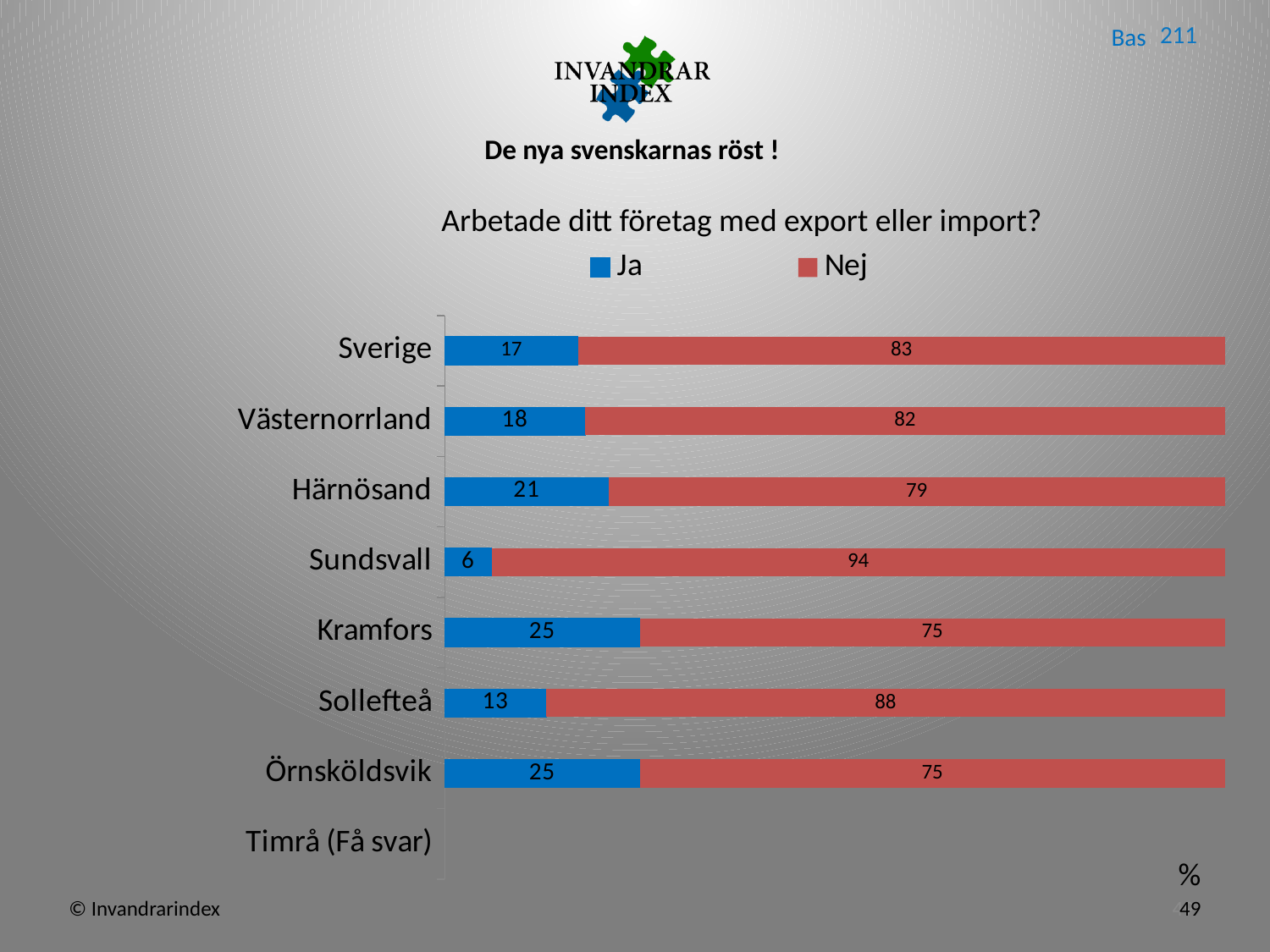
What is the value for "Ja" for Sundsvall? 6 Which category has the lowest value for "Ja"? Sundsvall What kind of chart is shown on the slide? Stacked bar chart Which is larger, the "Ja" value for Härnösand or the "Ja" value for Sverige? Härnösand What is the value for "Ja" for Sollefteå? 13 What is the value for "Nej" for Härnösand? 79 Which category is listed with "Få svar" and has no bar plotted? Timrå What is the value for "Nej" for Västernorrland? 82 What is the total of the stacked bar for Kramfors? 100 What is the difference between the "Nej" values for Sollefteå and Kramfors? 13 How many series does the legend list? 2 Which category has the highest value for "Nej"? Sundsvall